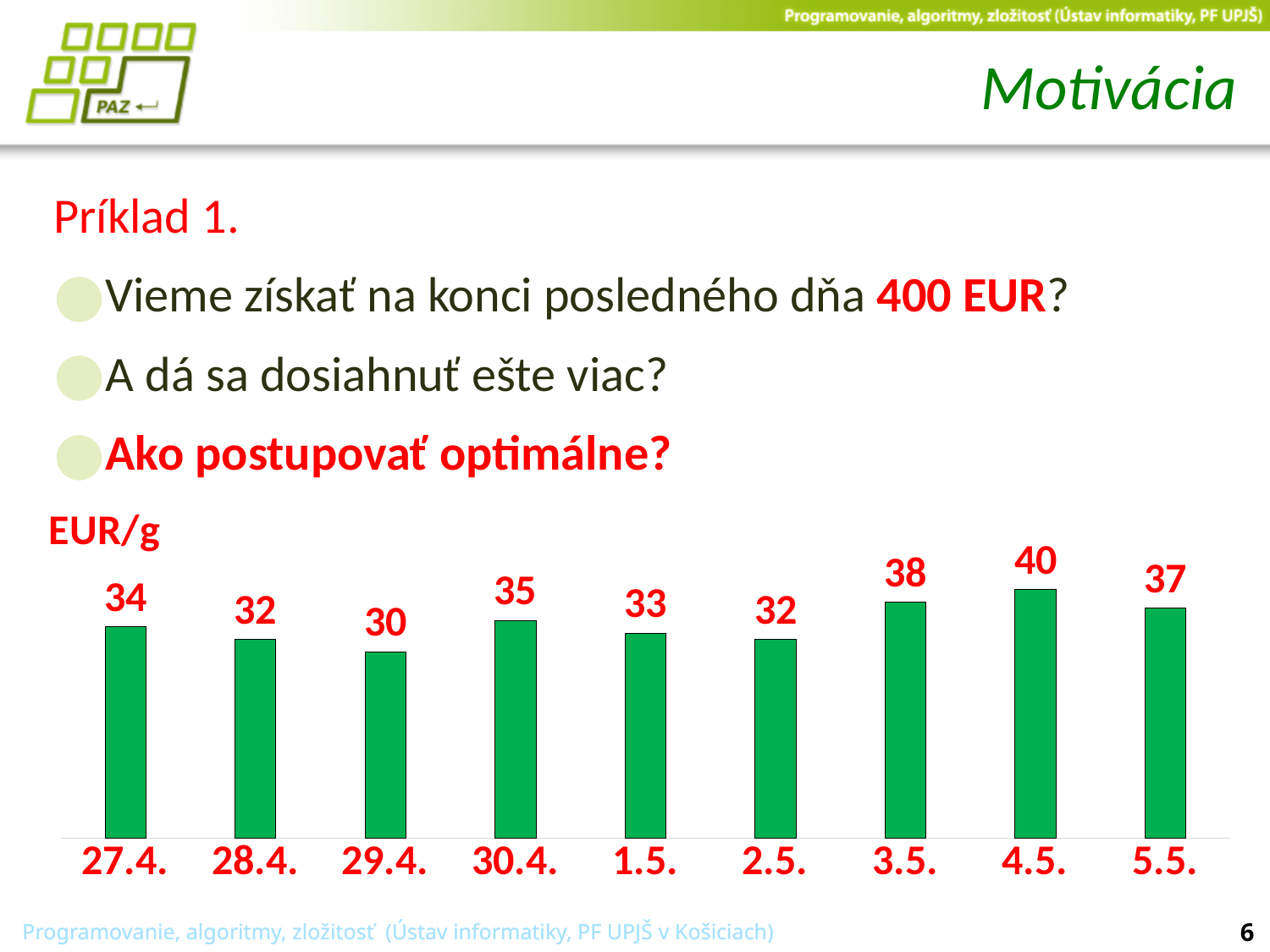
What is the value for 3.5.? 38 Which is larger, the value for 30.4. or the value for 2.5.? 30.4. What is the difference between the values for 5.5. and 1.5.? 4 Do the values rise or fall from 2.5. to 4.5.? rise What is the value for 27.4.? 34 Which date has the lowest value? 29.4. What unit label is shown above the chart? EUR/g What is the difference between the values for 4.5. and 29.4.? 10 What kind of chart is shown on the slide? bar chart How many dates are shown on the x axis? 9 Which date has the highest value? 4.5. What is the value for 30.4.? 35